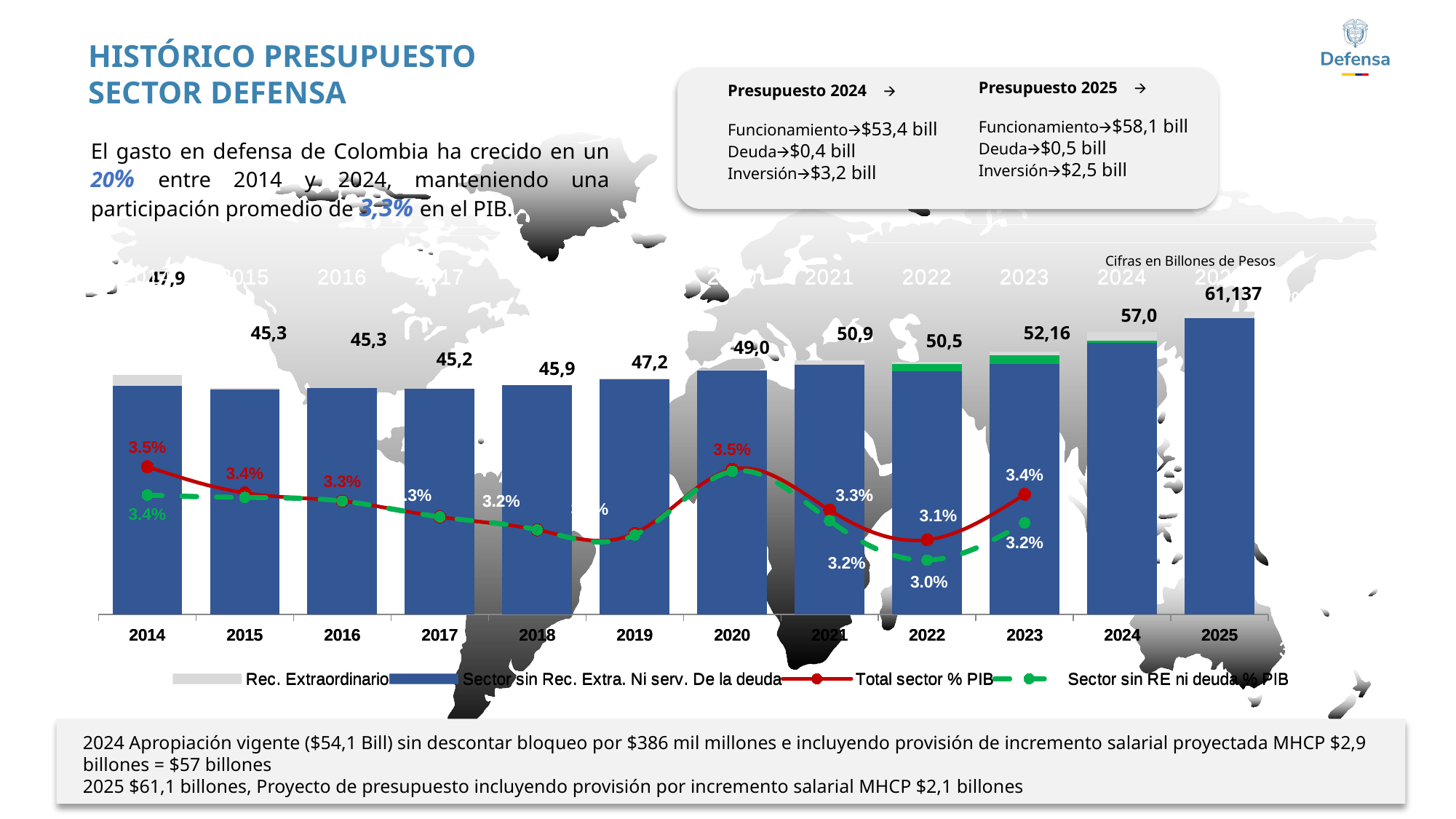
How many series does the chart legend list? 4 Which year has the larger labelled budget value, 2021 or 2022? 2021 Which year has the lowest labelled budget value? 2017 How many years are shown on the x axis of the chart? 12 What is the difference between the labelled budget values for 2025 and 2024? 4,137 What is the 'Sector sin RE ni deuda % PIB' value labelled for 2022? 3.0% What is the labelled budget value for 2025? 61,137 Which year has the highest labelled budget value? 2025 What is the difference between the labelled budget values for 2024 and 2014? 9,1 What is the 'Total sector % PIB' value labelled for 2022? 3.1% What kind of chart is shown on the slide? Combined bar and line chart What is the labelled budget value for 2024? 57,0